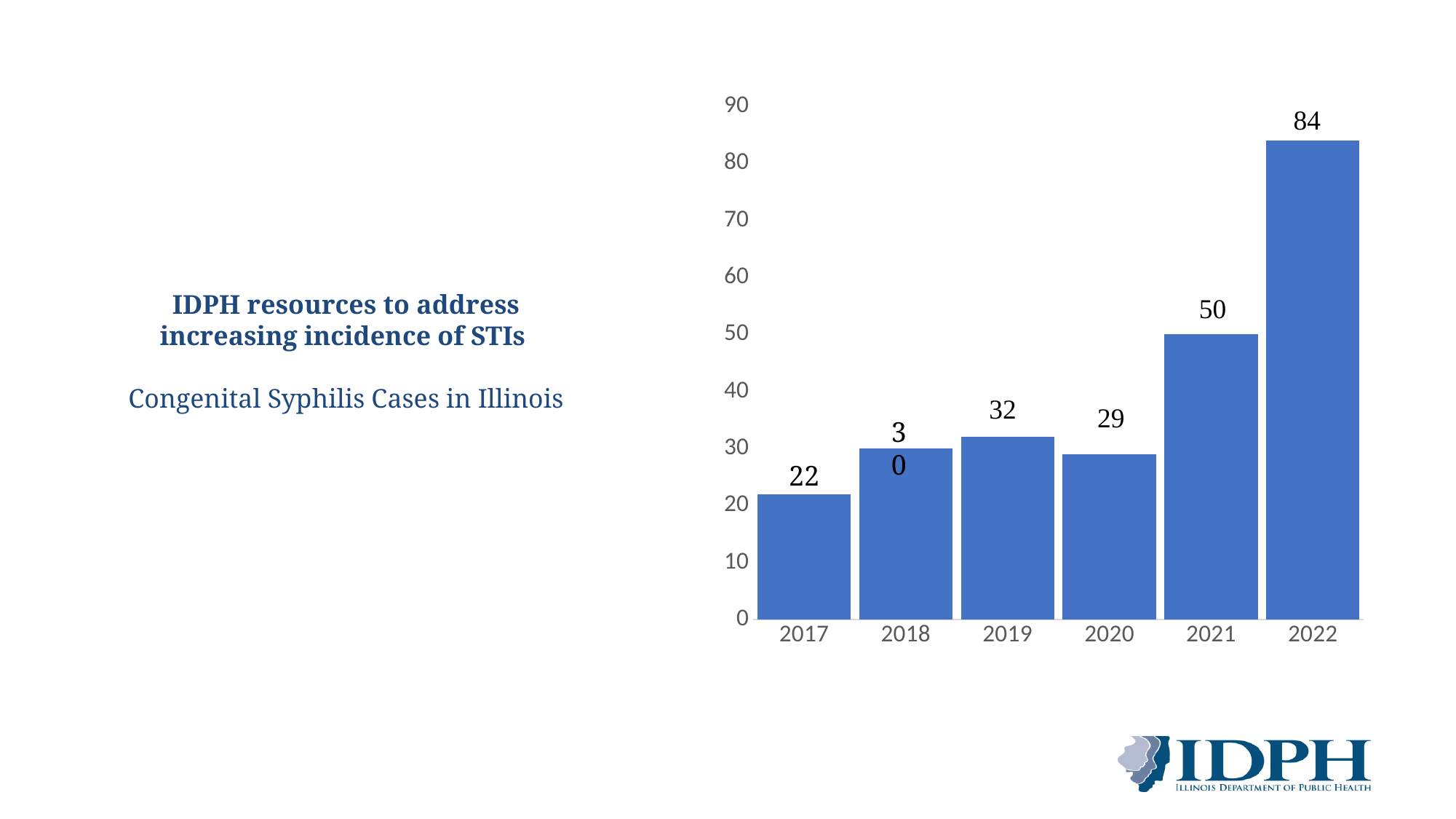
What is the difference between the 2019 and 2020 values? 3 How many congenital syphilis cases were reported in Illinois in 2022? 84 What type of chart is shown on the slide? bar chart What is the title of the chart on the slide? Congenital Syphilis Cases in Illinois How many years are shown on the x axis of the chart? 6 Which year has more cases, 2019 or 2021? 2021 What is the value for 2021 in the chart? 50 What is the value for 2020 in the chart? 29 Which year has the highest number of congenital syphilis cases? 2022 What is the difference between the 2022 and 2021 values? 34 What is the value for 2017 in the congenital syphilis cases chart? 22 Which year has the lowest number of congenital syphilis cases? 2017